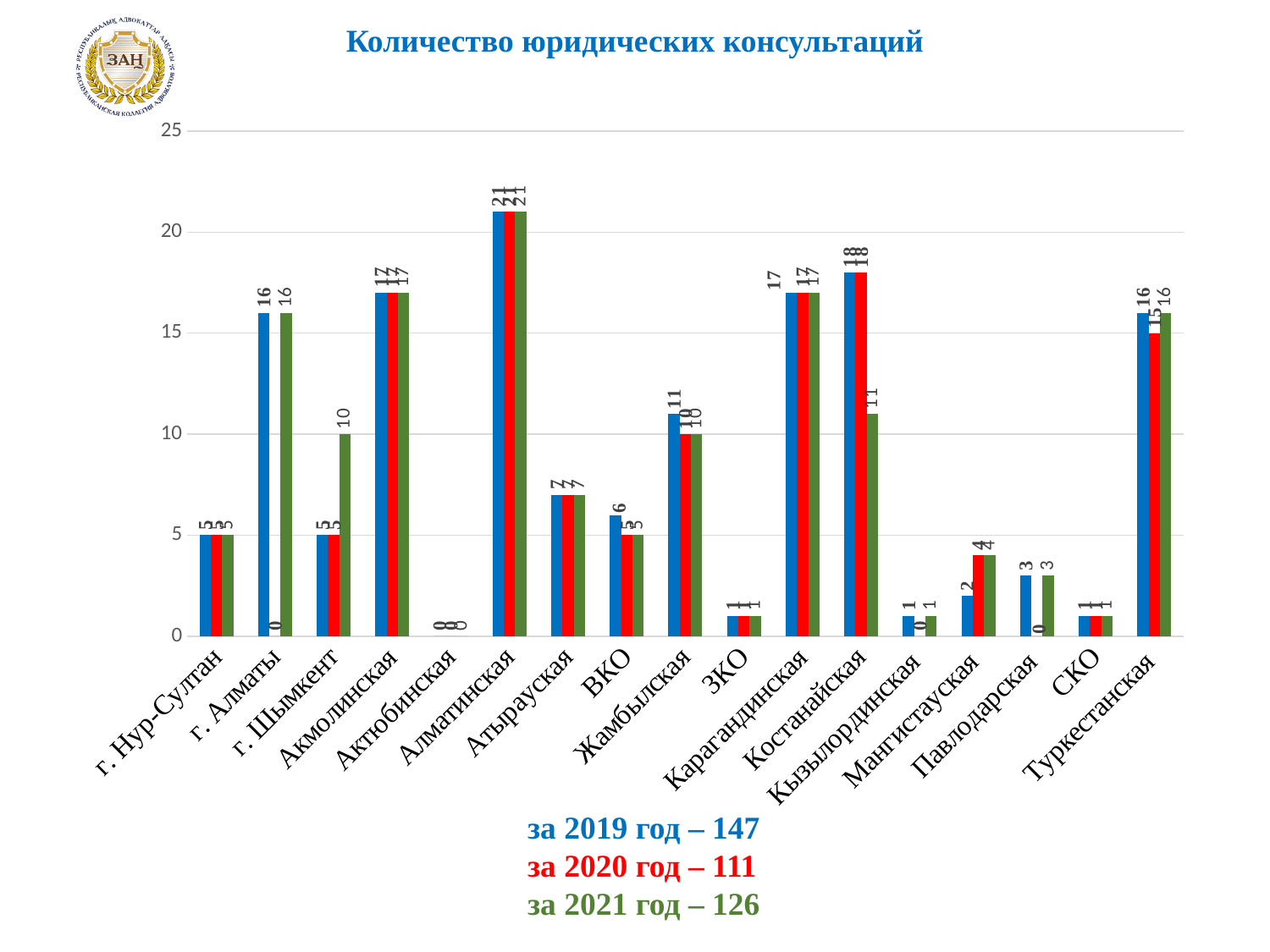
What is the value of the green (2021) bar for Костанайская? 11 What is the difference between the blue (2019) bar and the green (2021) bar for Костанайская? 7 What kind of chart is shown on the slide? bar chart What is the value of the blue (2019) bar for Алматинская? 21 What is the value of the red (2020) bar for г. Алматы? 0 Which is larger: the blue (2019) bar for г. Алматы or the red (2020) bar for Туркестанская? г. Алматы Is the value of the red (2020) bar for Алматинская greater or less than 20? greater Which region has the highest bars in the chart? Алматинская What is the value of the blue (2019) bar for Мангистауская? 2 What is the title of the chart? Количество юридических консультаций What is the value of the green (2021) bar for г. Шымкент? 10 How many regions (categories) are shown along the x axis of the chart? 17